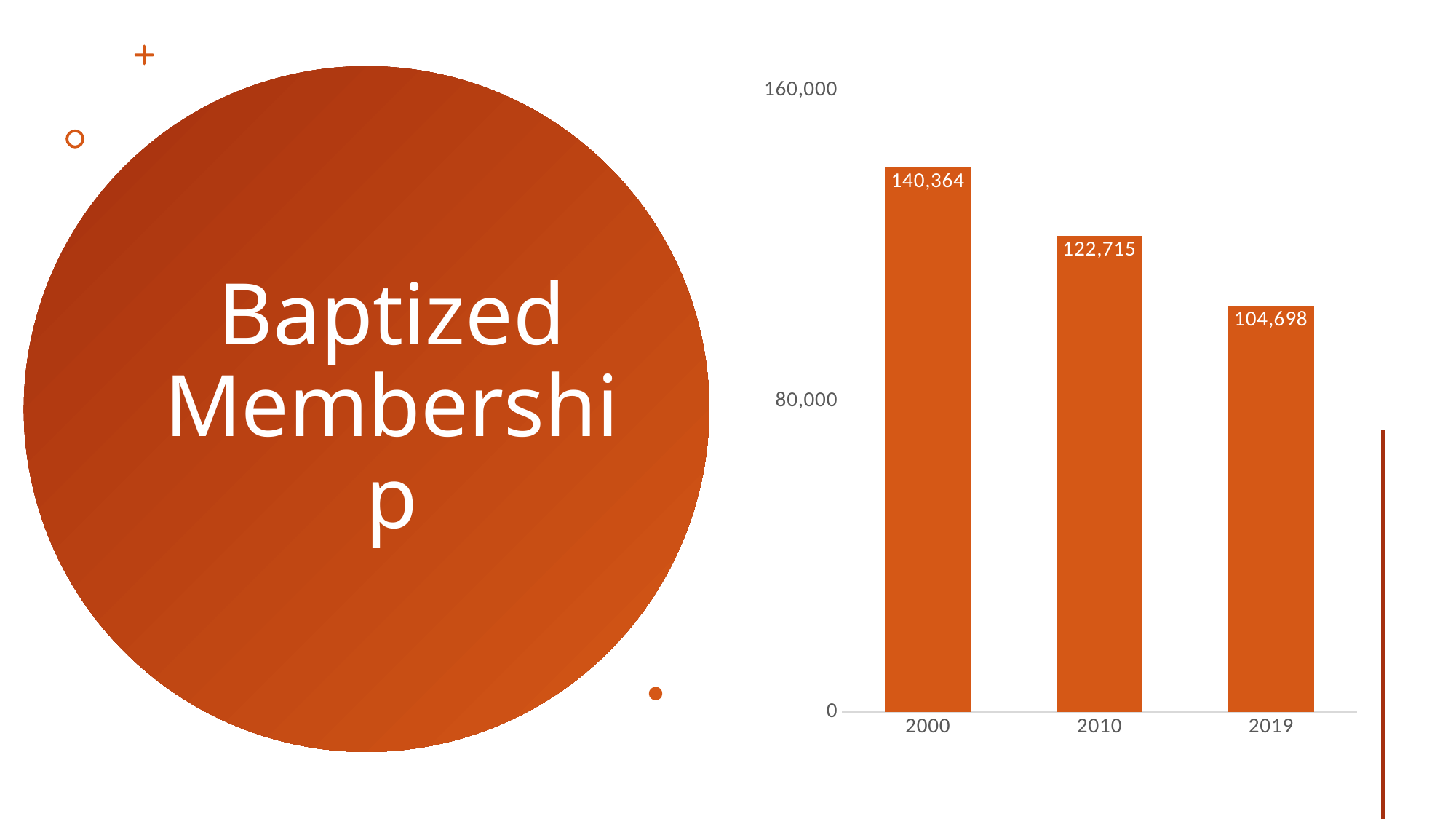
How many years are shown on the chart? 3 Which year has the lowest baptized membership? 2019 What kind of chart is shown on the slide? bar chart What is the difference between the 2000 and 2010 values? 17,649 Do the values rise or fall from 2000 to 2019? fall Which year has the highest baptized membership? 2000 What is the baptized membership value for 2000? 140,364 What is the baptized membership value for 2019? 104,698 Which is larger, the value for 2010 or the value for 2019? 2010 Is the value for 2019 greater or less than 80,000? greater What is the difference between the 2000 and 2019 values? 35,666 What is the baptized membership value for 2010? 122,715